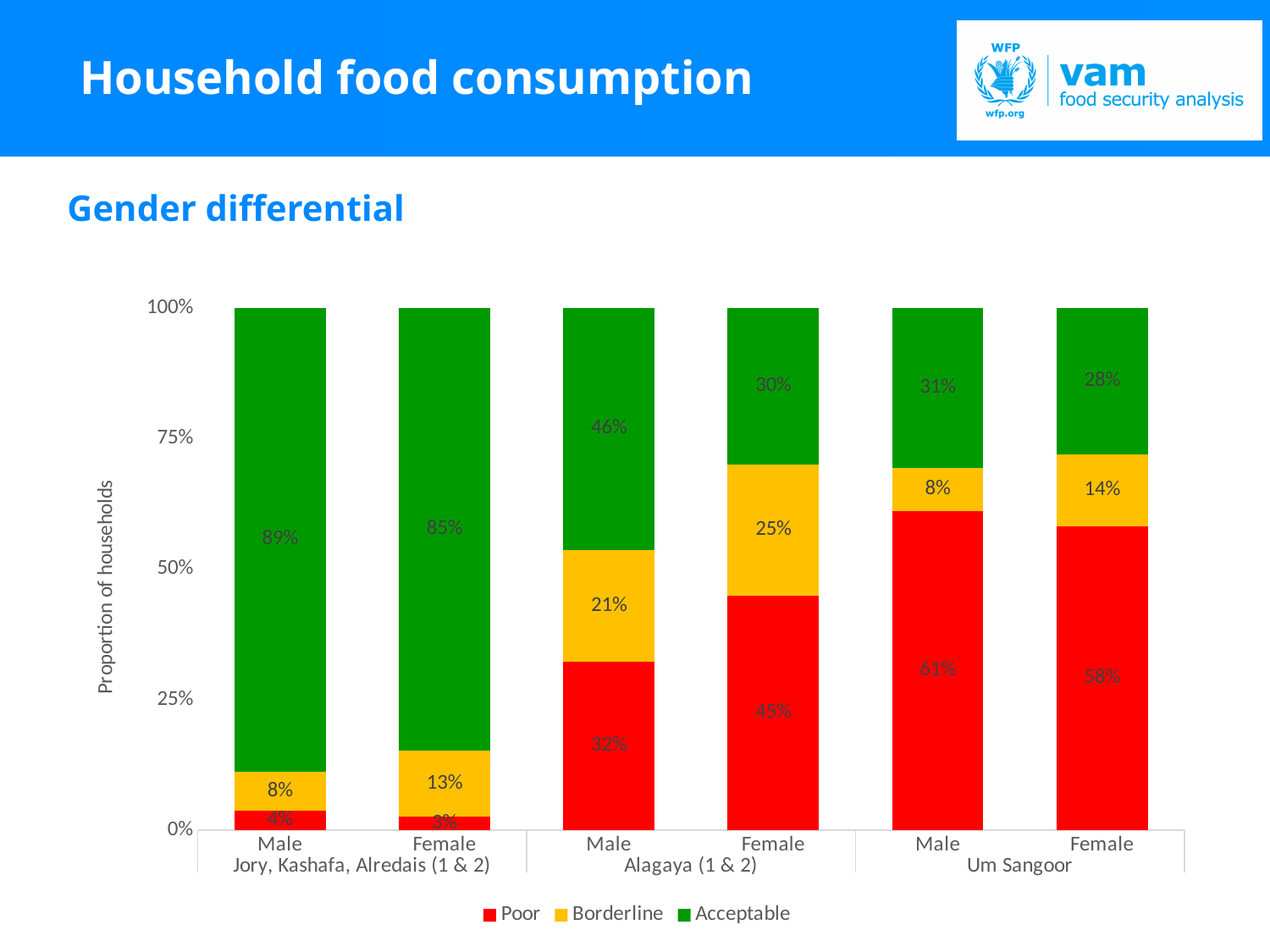
Which bar has the highest Poor share? Male, Um Sangoor What is the difference between the Poor share for Female and Male households in Alagaya (1 & 2)? 13% Which is larger, the Borderline share for Female households in Um Sangoor or for Male households in Um Sangoor? Female, Um Sangoor How many bars are plotted in the chart? 6 Which bar has the lowest Acceptable share? Female, Um Sangoor What is the Borderline share for Female households in Alagaya (1 & 2)? 25% What is the Acceptable share for Male households in Jory, Kashafa, Alredais (1 & 2)? 89% How many series does the legend list? 3 What is the label of the y axis? Proportion of households What is the Poor share for Male households in Um Sangoor? 61% What kind of chart is shown on the slide? Stacked bar chart Is the Poor share for Female households in Alagaya (1 & 2) greater or less than 50%? less